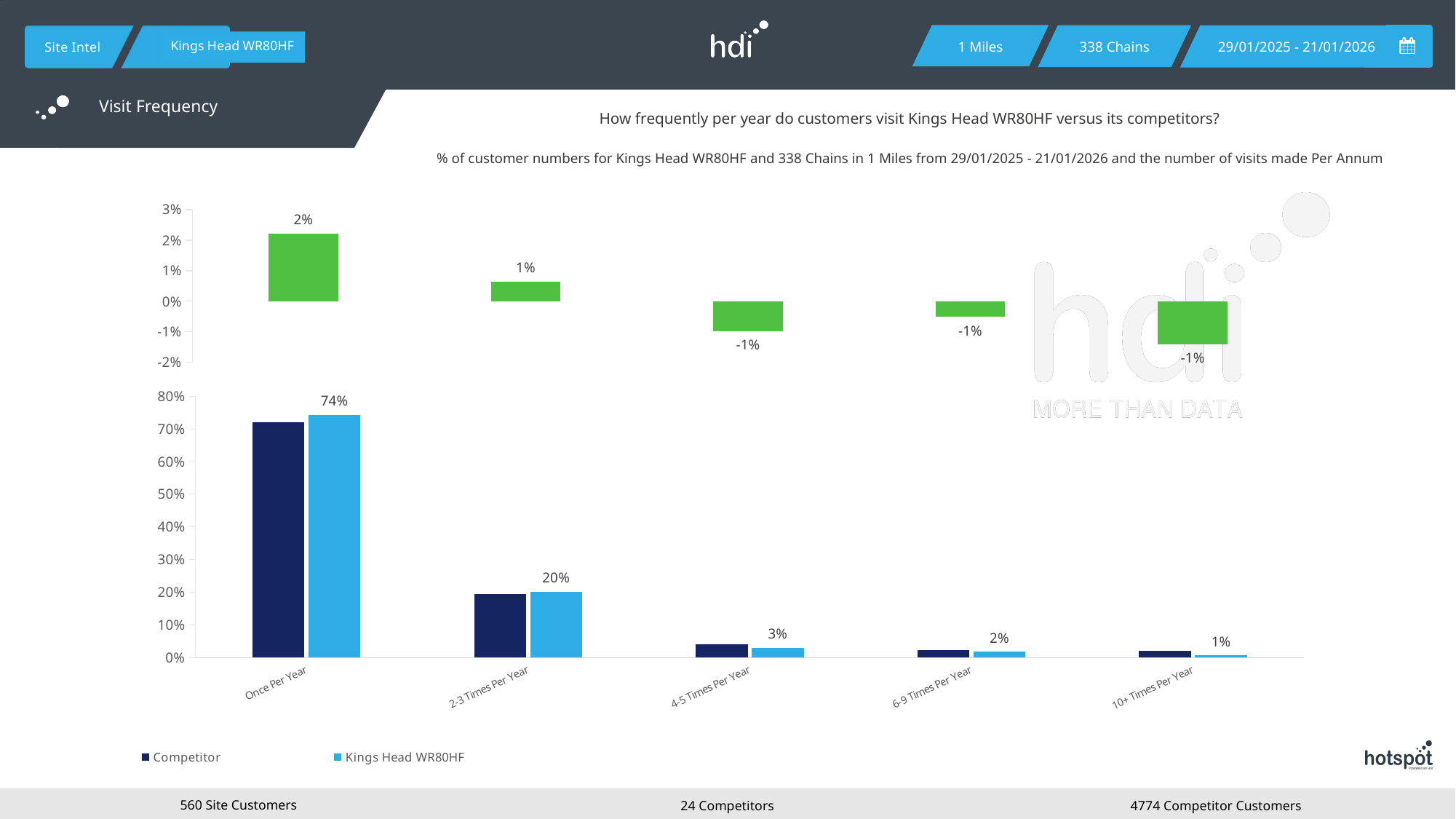
How many categories are shown on the x axis of the lower chart? 5 In the lower chart, what is the value for Kings Head WR80HF for 10+ Times Per Year? 1% In the lower chart, is the Competitor value for Once Per Year greater or less than 60%? greater In the lower chart, which category has the highest value for Kings Head WR80HF? Once Per Year In the lower chart, what is the value for Kings Head WR80HF for 4-5 Times Per Year? 3% In the lower chart, what is the value for Kings Head WR80HF for Once Per Year? 74% In the lower chart, what is the value for Kings Head WR80HF for 2-3 Times Per Year? 20% In the upper green chart, what is the value for 2-3 Times Per Year? 1% In the lower chart, what is the difference between the Kings Head WR80HF values for Once Per Year and 2-3 Times Per Year? 54% In the upper green chart, what is the value for Once Per Year? 2% In the lower chart, is the Competitor value for 2-3 Times Per Year greater or less than 30%? less How many series does the legend of the lower chart list? 2